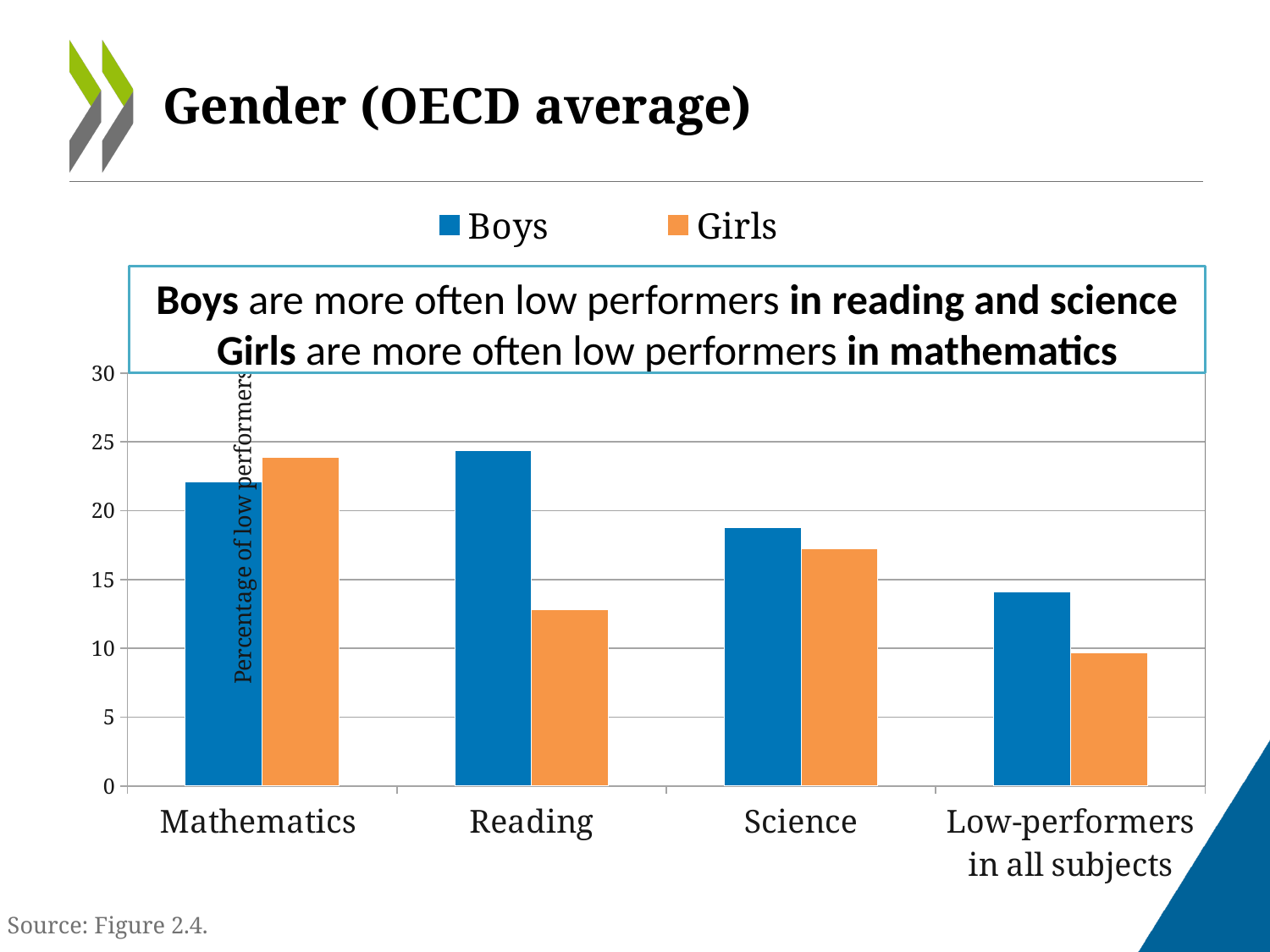
Among the Boys bars, which category has the highest value? Reading How many series does the chart's legend list? 2 Is the value for Girls in Reading greater or less than 15? less In Low-performers in all subjects, which is larger, the value for Boys or the value for Girls? Boys In Reading, which is larger, the value for Boys or the value for Girls? Boys In Mathematics, which is larger, the value for Boys or the value for Girls? Girls Among the Girls bars, which category has the lowest value? Low-performers in all subjects Is the value for Boys in Mathematics greater or less than 20? greater How many categories are shown on the x axis of the chart? 4 What is the label of the chart's vertical axis? Percentage of low performers Which series are listed in the chart's legend? Boys and Girls What kind of chart is shown on the slide? Bar chart